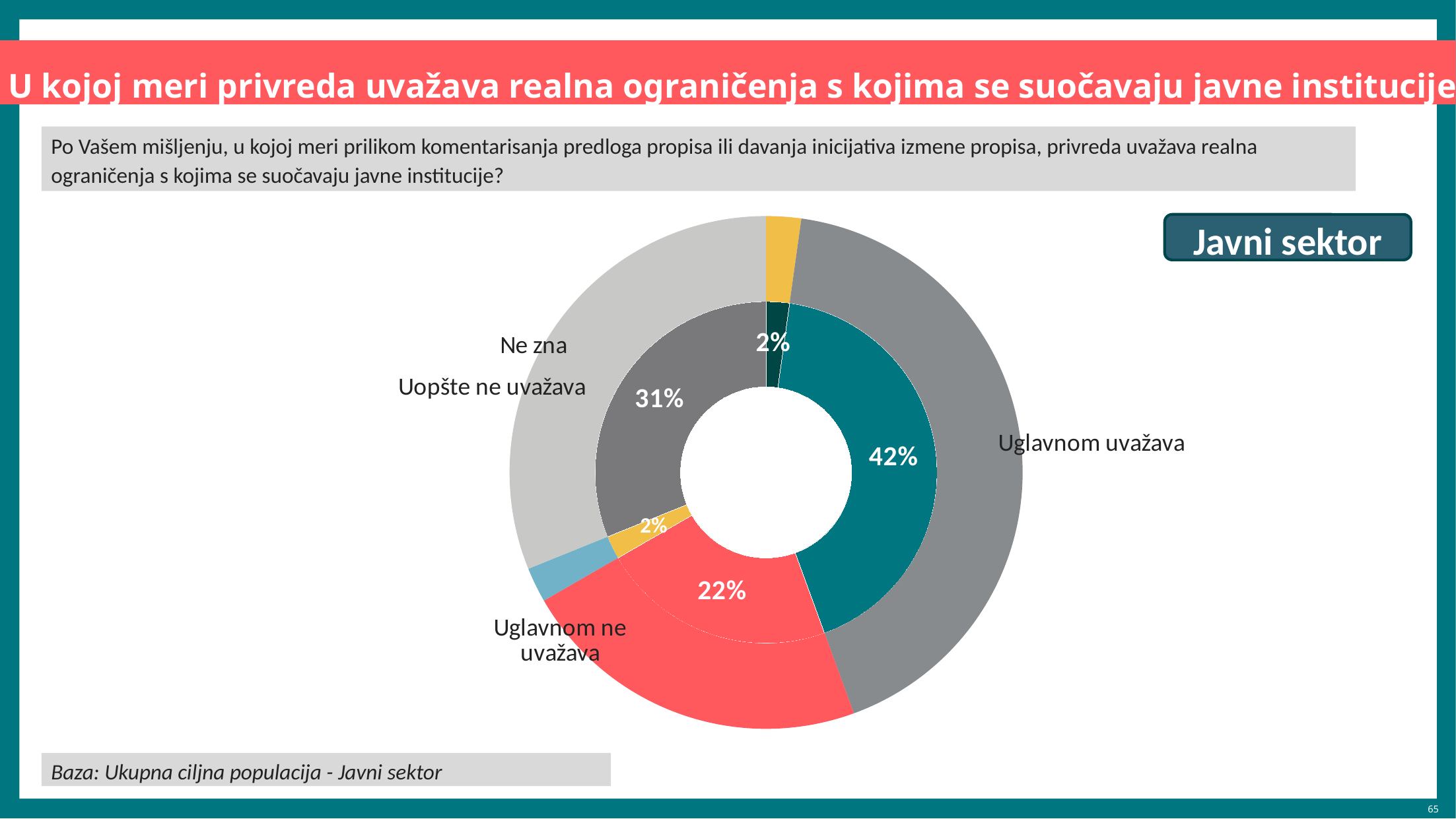
Which is larger, the share for "Uglavnom uvažava" or for "Uglavnom ne uvažava"? Uglavnom uvažava How many percentage labels are shown on the inner ring of the chart? 5 Which category has the largest share in the chart? Uglavnom uvažava What kind of chart is shown on the slide? Doughnut (pie) chart What percentage is shown for "Uglavnom uvažava"? 42% Which sector does the chart refer to, according to the label in the top right? Javni sektor What is the difference in percentage points between "Uglavnom uvažava" (42%) and "Uglavnom ne uvažava" (22%)? 20 percentage points What percentage is shown for "Uglavnom ne uvažava"? 22% What colour is the segment labelled 42%? Teal What is the smallest percentage value labelled on the chart? 2% What is the largest percentage value labelled on the chart? 42%